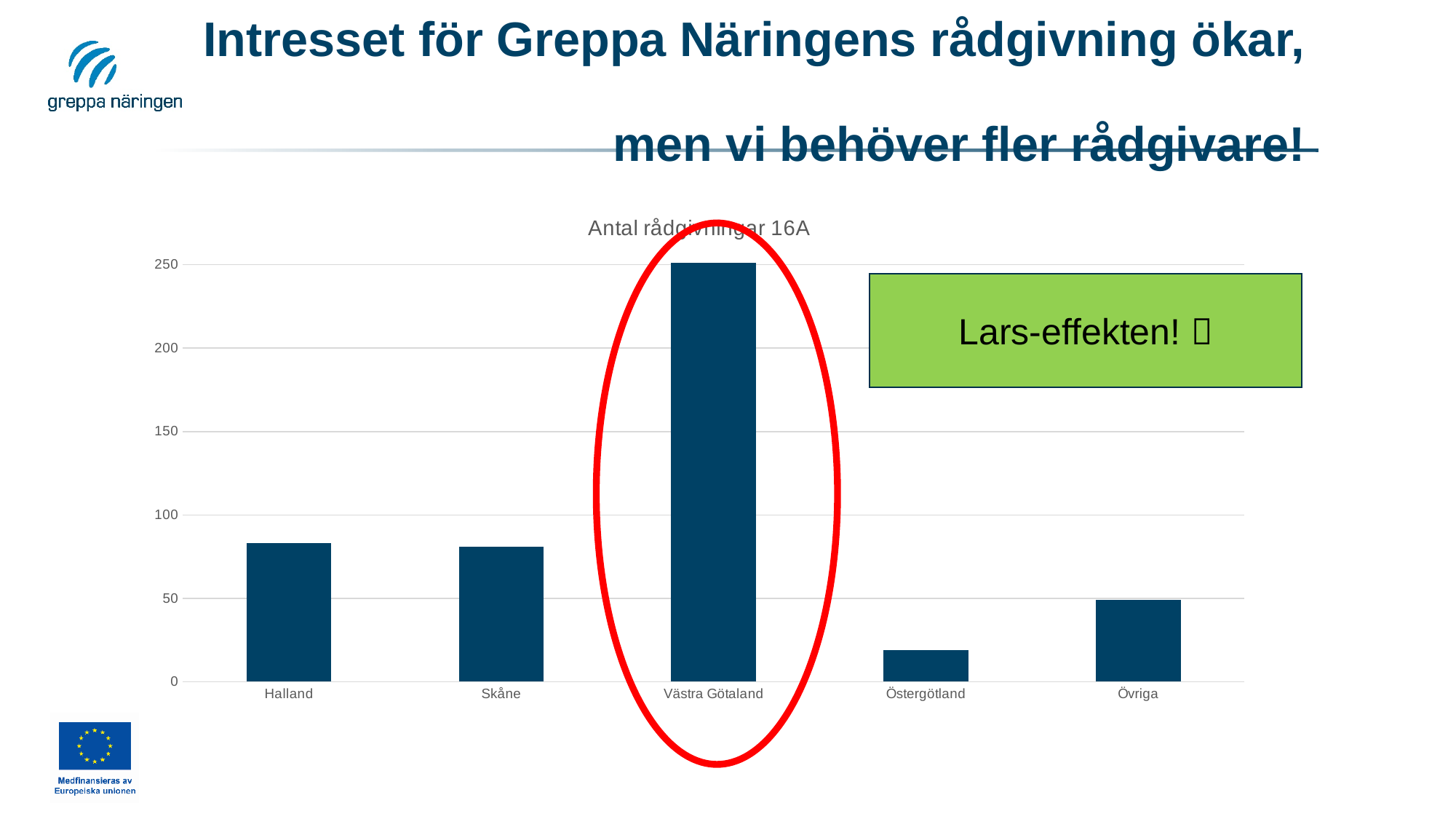
Is the value for Halland greater or less than 100? less Which category has the lowest value in the chart? Östergötland Which category has the highest value in the chart? Västra Götaland What kind of chart is shown on the slide? bar chart Which is larger, the value for Övriga or the value for Östergötland? Övriga Which is larger, the value for Skåne or the value for Övriga? Skåne Is the value for Västra Götaland greater or less than 200? greater Is the value for Skåne greater or less than 50? greater What is the highest value shown on the vertical axis of the chart? 250 How many categories are shown on the x axis of the chart? 5 What is the title of the chart? Antal rådgivningar 16A